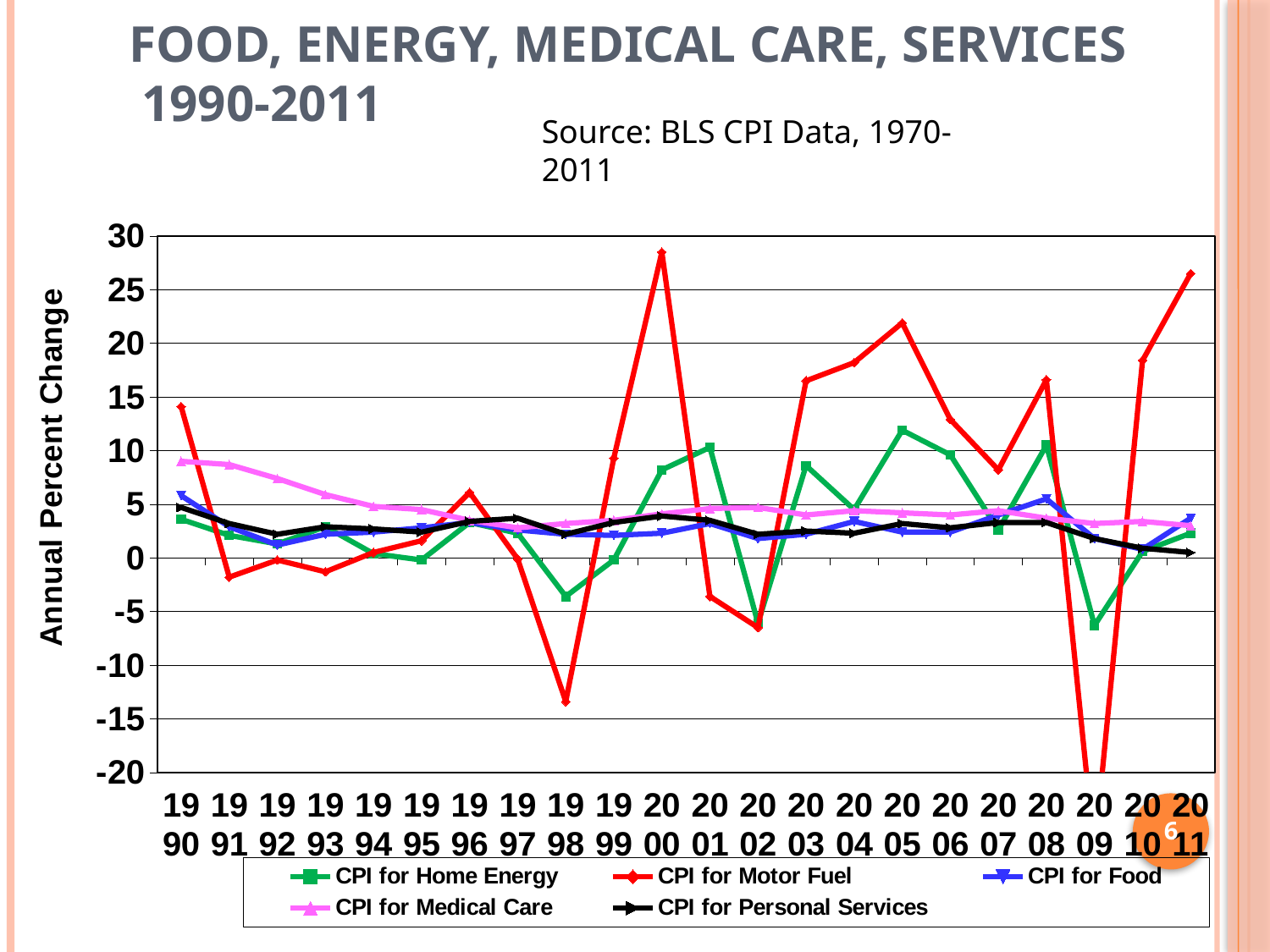
In which year does CPI for Motor Fuel reach its lowest value? 2009 Is the value for CPI for Home Energy in 2005 greater or less than 10? greater How many years are plotted along the x axis? 22 In 2000, which is larger: CPI for Motor Fuel or CPI for Home Energy? CPI for Motor Fuel Is the value for CPI for Motor Fuel in 2009 greater or less than -15? less Is the value for CPI for Medical Care in 1990 greater or less than 5? greater Which series has the highest value in 2000? CPI for Motor Fuel What kind of chart is shown on the slide? line chart Does CPI for Medical Care rise or fall from 1990 to 1995? fall How many series does the legend list? 5 In which year does CPI for Motor Fuel reach its highest value? 2000